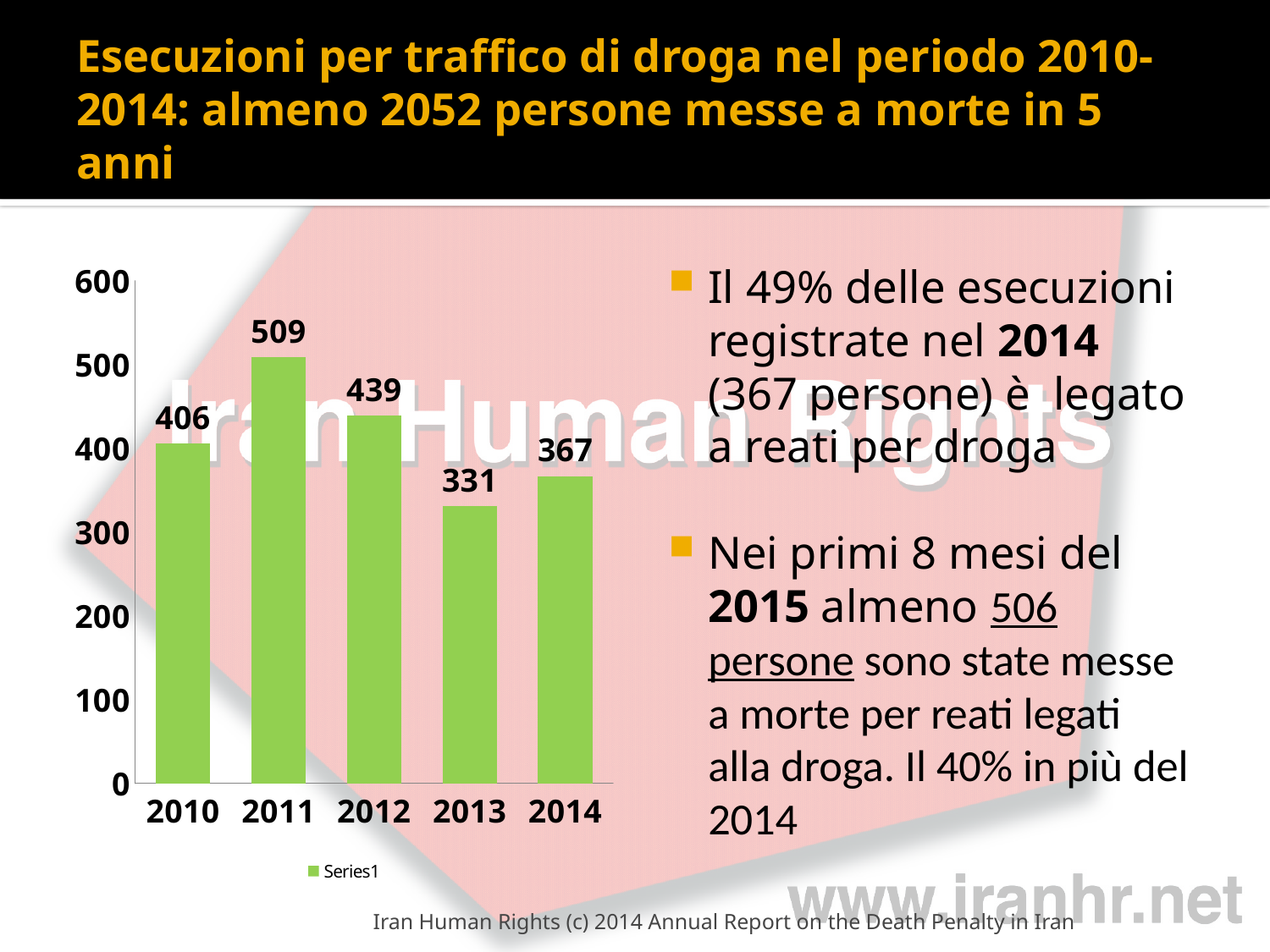
What is the legend entry shown below the chart? Series1 Which is larger, the value for 2012 or the value for 2014? 2012 Which year has the lowest value? 2013 What is the value for 2013? 331 How many series does the legend list? 1 What is the value for 2010? 406 Is the value for 2014 greater or less than 400? less What is the difference between the values for 2011 and 2013? 178 What is the value for 2011? 509 What kind of chart is shown on the slide? bar chart How many years are shown on the x axis? 5 Which year has the highest value? 2011